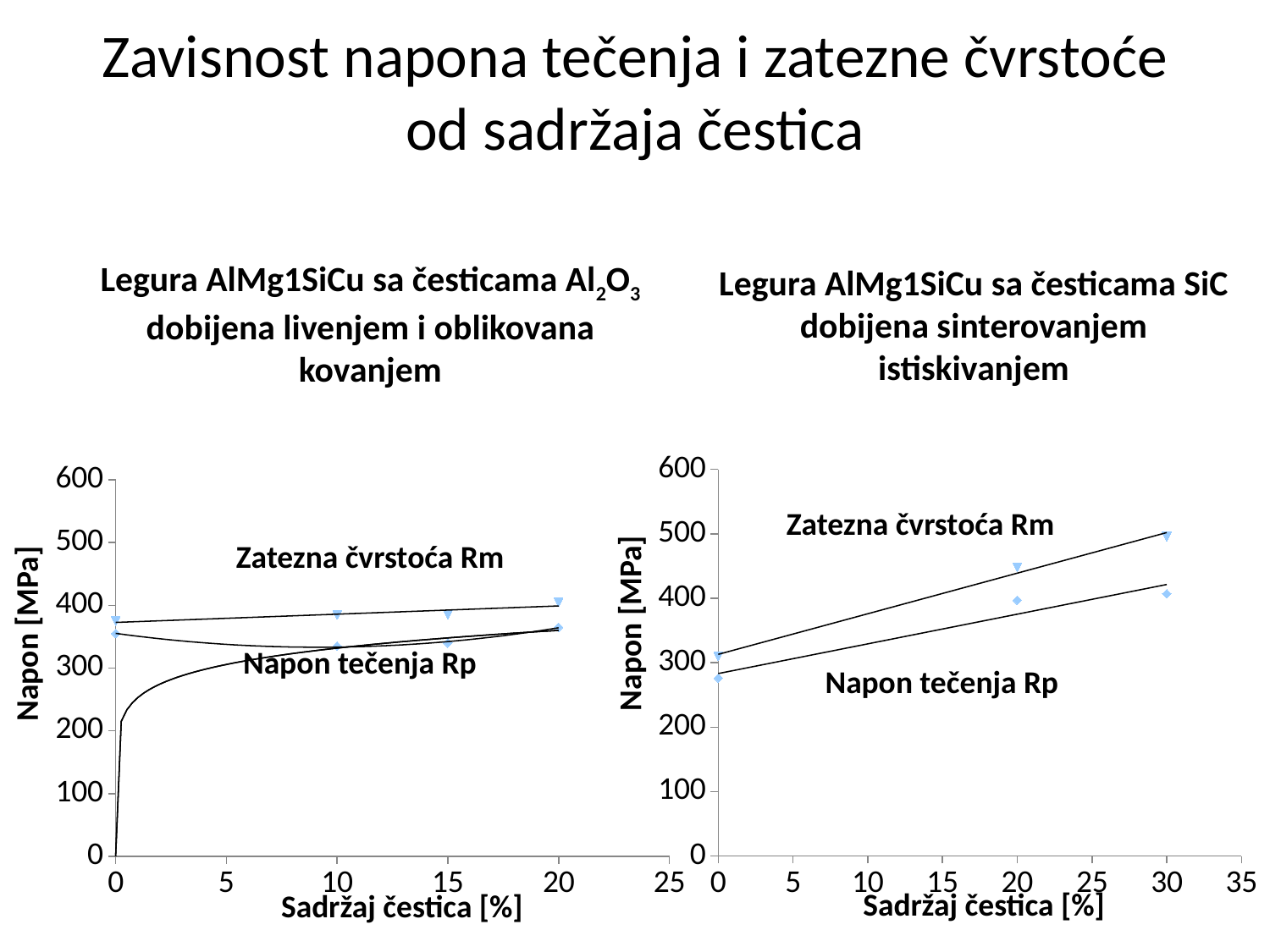
In the left chart (Legura AlMg1SiCu sa česticama Al2O3), is the value of Zatezna čvrstoća Rm at 0% particle content greater or less than 400? less In the right chart (Legura AlMg1SiCu sa česticama SiC), is the value of Zatezna čvrstoća Rm at 30% particle content greater or less than 400? greater In the left chart (Legura AlMg1SiCu sa česticama Al2O3), how many data points are plotted for Zatezna čvrstoća Rm? 4 In the left chart (Legura AlMg1SiCu sa česticama Al2O3), is the value of Napon tečenja Rp at 10% particle content greater or less than 400? less In the right chart (Legura AlMg1SiCu sa česticama SiC), how many data points are plotted for Zatezna čvrstoća Rm? 3 What is the y-axis label of the left chart (Legura AlMg1SiCu sa česticama Al2O3)? Napon [MPa] What kind of chart is the left chart (Legura AlMg1SiCu sa česticama Al2O3)? scatter chart In the right chart (Legura AlMg1SiCu sa česticama SiC), at which particle content is Zatezna čvrstoća Rm highest? 30 In the right chart (Legura AlMg1SiCu sa česticama SiC), does Zatezna čvrstoća Rm rise or fall as particle content increases? rise In the right chart (Legura AlMg1SiCu sa česticama SiC), at 30% particle content, which is larger: Zatezna čvrstoća Rm or Napon tečenja Rp? Zatezna čvrstoća Rm